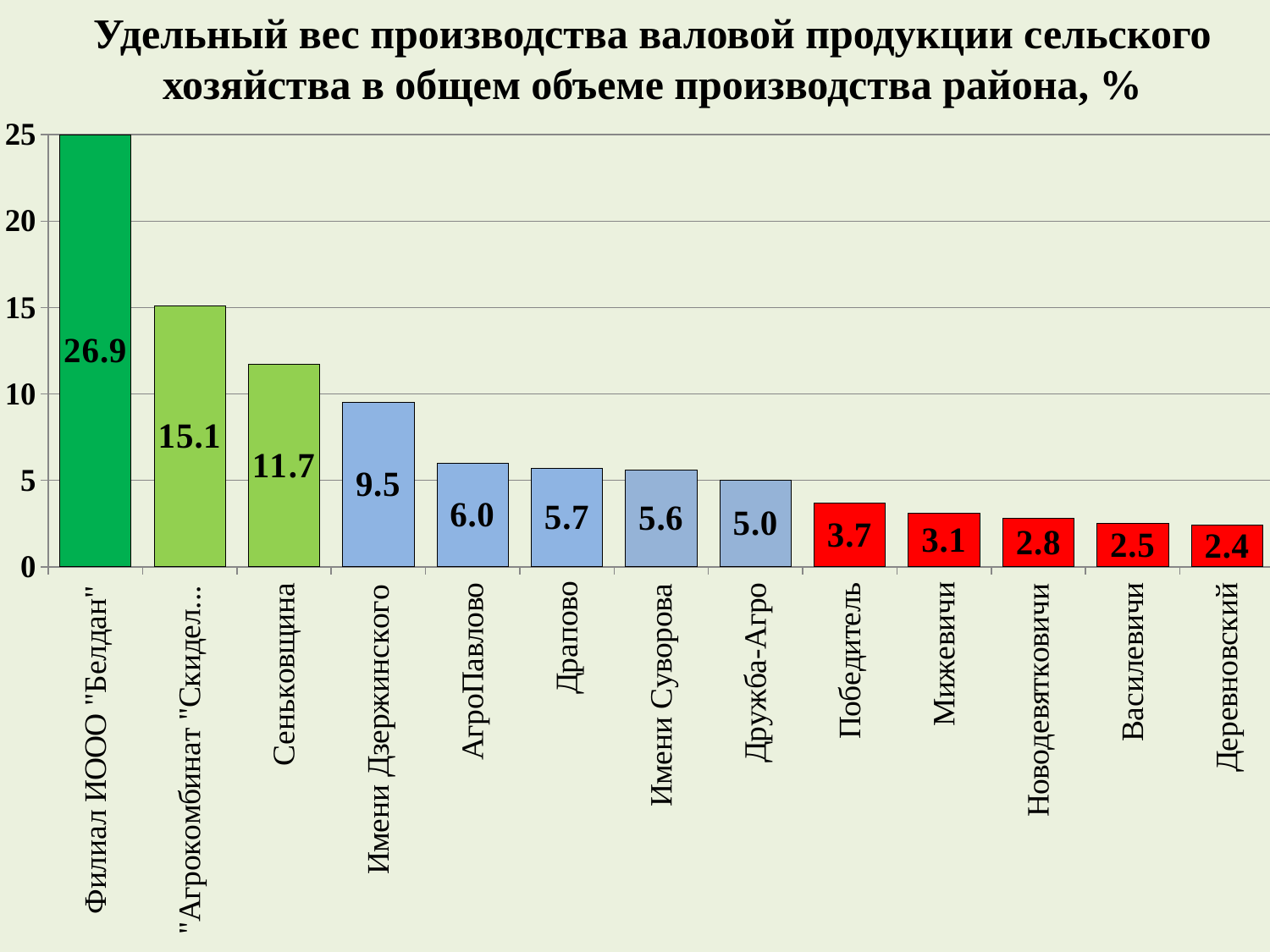
What is the value for Новодевятковичи? 2.8 What is the difference between the values for Сеньковщина and Имени Дзержинского? 2.2 Which is larger, the value for АгроПавлово or the value for Дружба-Агро? АгроПавлово How many categories are shown in the chart? 13 Which category has the lowest value? Деревновский What kind of chart is shown on the slide? bar chart What is the value for Сеньковщина? 11.7 Which category has the highest value? Филиал ИООО "Белдан" What is the value for Имени Дзержинского? 9.5 Is the value for Мижевичи greater or less than 5? less What is the value for Победитель? 3.7 What colour are the bars for Победитель, Мижевичи, Новодевятковичи, Василевичи and Деревновский? red